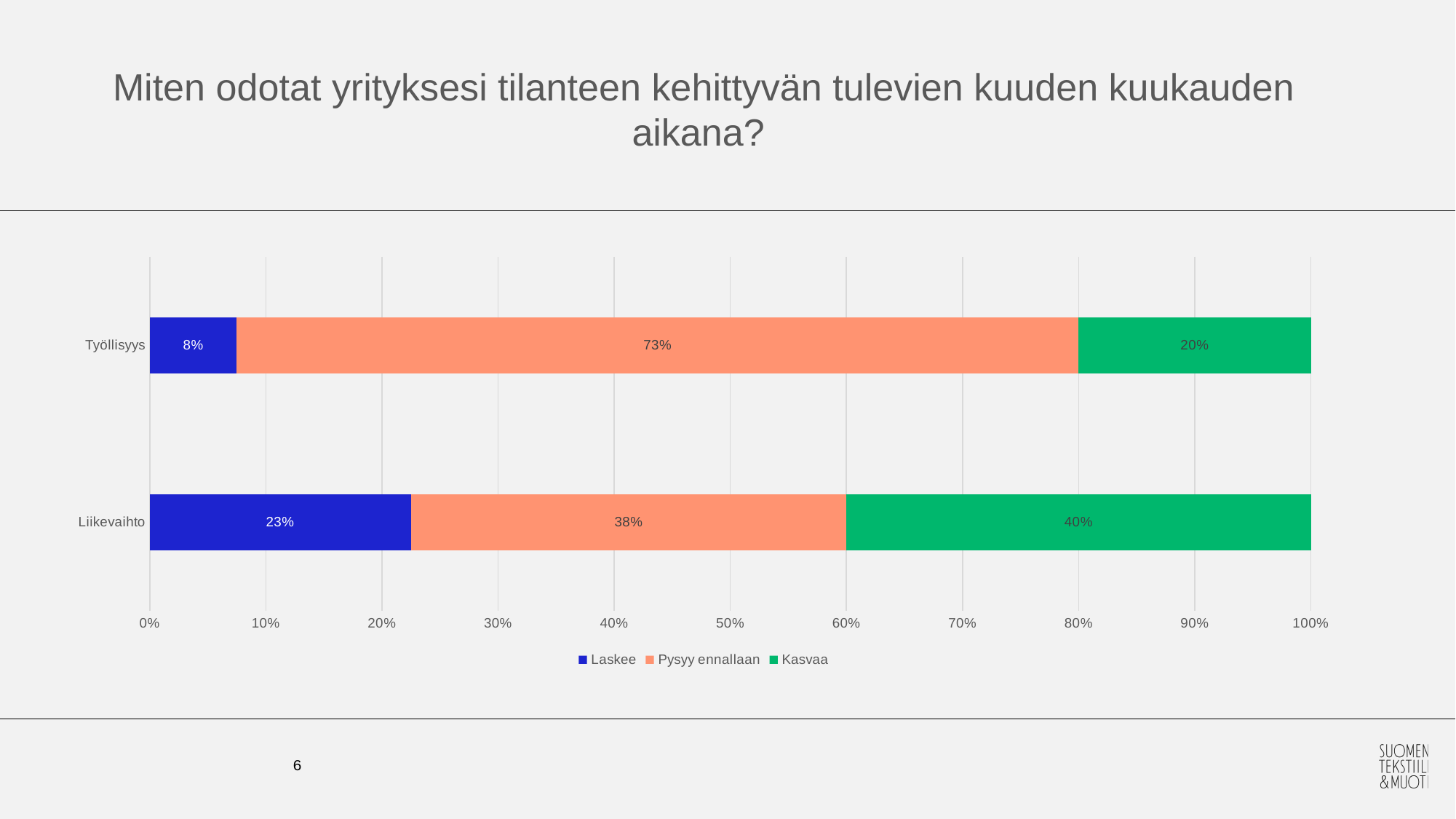
What kind of chart is shown on the slide? Stacked bar chart Which series is shown in green in the legend? Kasvaa What is the difference between the Pysyy ennallaan values for Työllisyys and Liikevaihto? 35% Which category has the higher Kasvaa value? Liikevaihto What is the Pysyy ennallaan value for Liikevaihto? 38% How many series does the legend list? 3 What is the difference between the Laskee values for Liikevaihto and Työllisyys? 15% How many categories are shown on the chart? 2 Which category has the higher Laskee value, Työllisyys or Liikevaihto? Liikevaihto What percentage of respondents expect Työllisyys to stay the same (Pysyy ennallaan)? 73% What is the Laskee value for Työllisyys? 8% What is the Kasvaa value for Liikevaihto? 40%